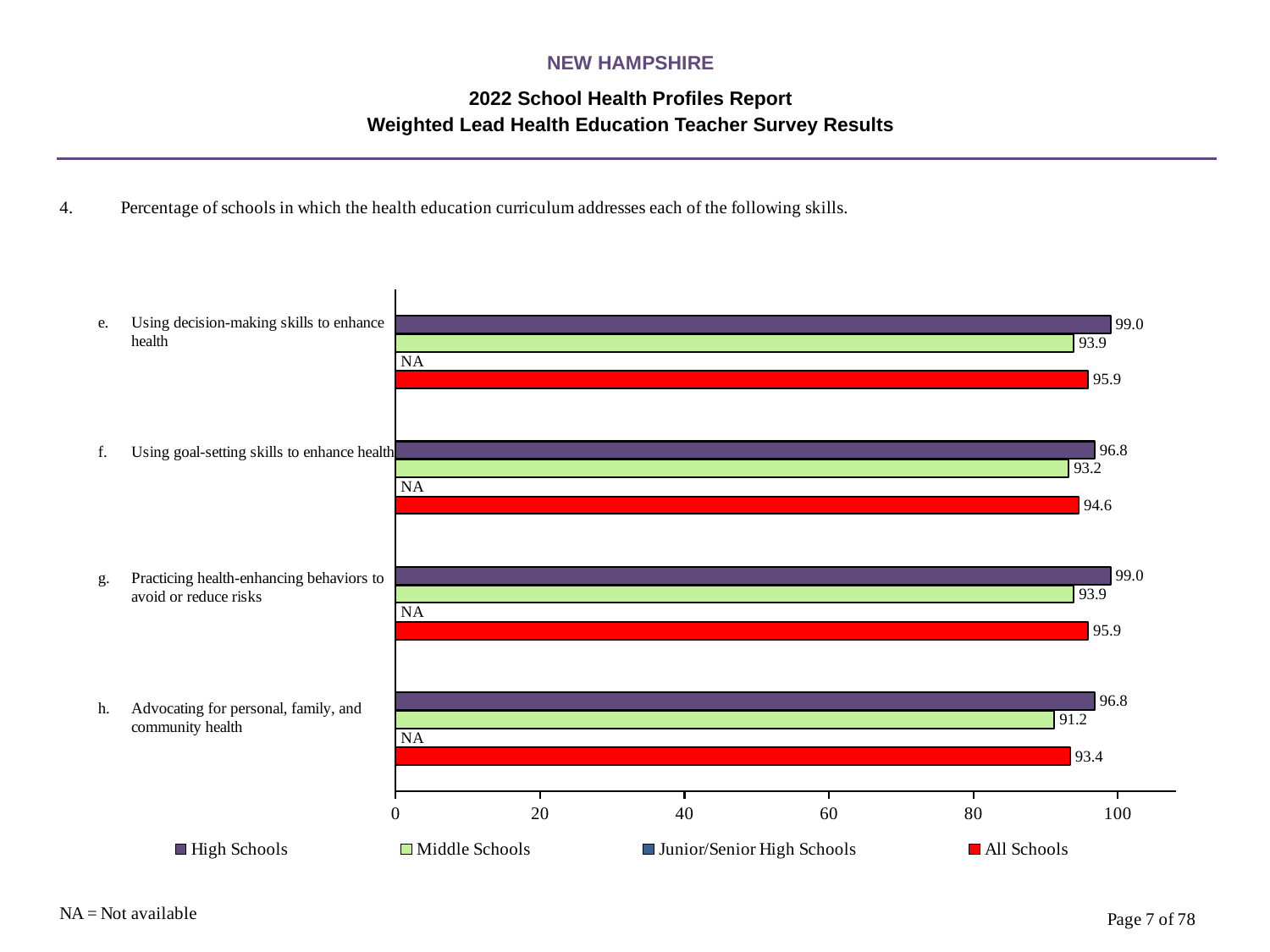
Which category has the lowest Middle Schools value? Advocating for personal, family, and community health What is the All Schools value for 'Using goal-setting skills to enhance health'? 94.6 Which legend entry is shown in red? All Schools How many skill categories are shown on the chart? 4 What is the Middle Schools value for 'Advocating for personal, family, and community health'? 91.2 Is the Middle Schools value for 'Using decision-making skills to enhance health' greater or less than 80? greater What kind of chart is shown on the slide? bar chart Which is larger for 'Advocating for personal, family, and community health': the High Schools value or the All Schools value? High Schools What is the Junior/Senior High Schools value for 'Practicing health-enhancing behaviors to avoid or reduce risks'? NA What is the difference between the High Schools and Middle Schools values for 'Using goal-setting skills to enhance health'? 3.6 What is the High Schools value for 'Using decision-making skills to enhance health'? 99.0 How many series does the legend list? 4